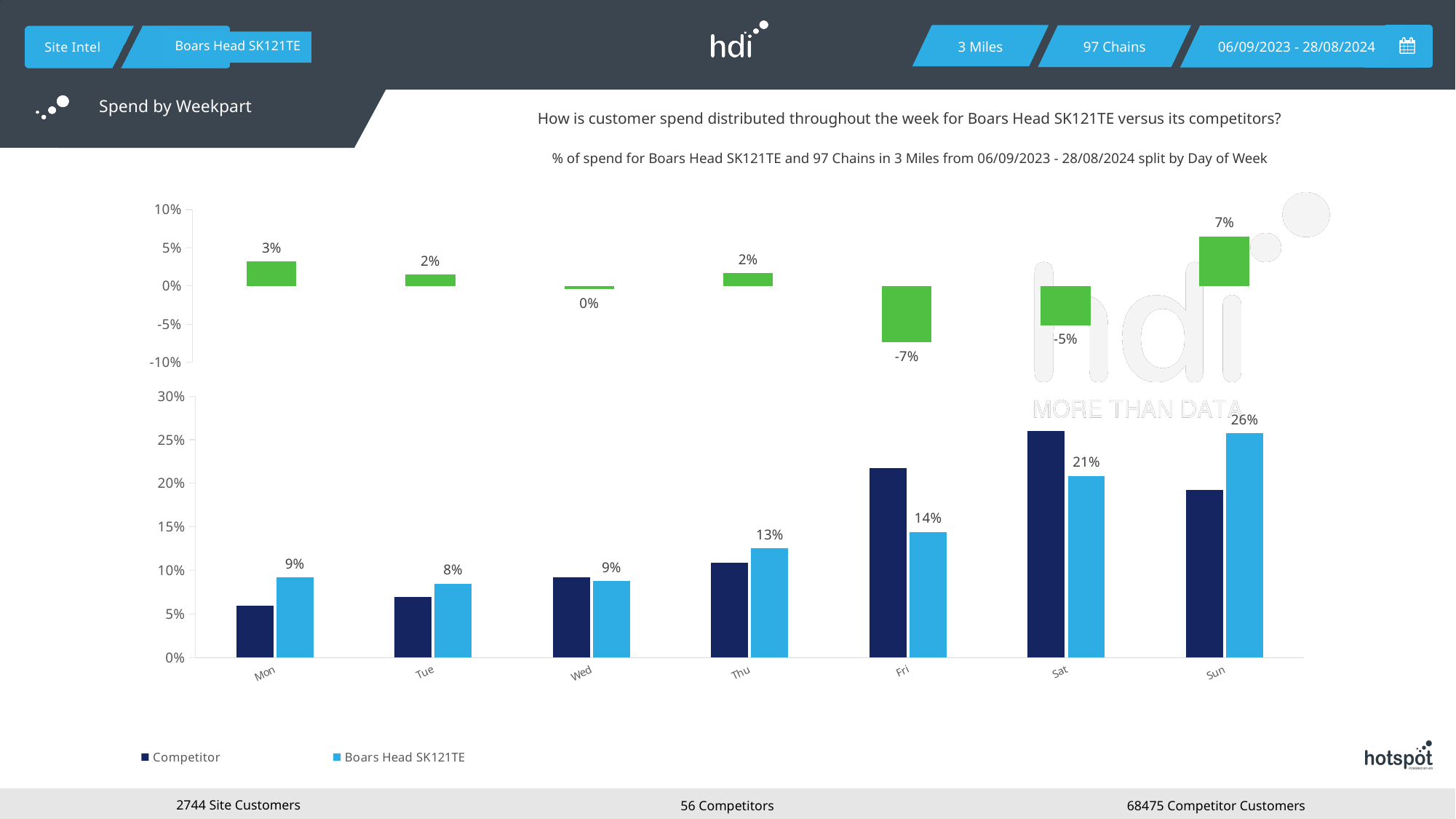
In the top chart, how many days are plotted? 7 What kind of chart is the bottom chart? bar chart In the bottom chart, what is the difference between the Boars Head SK121TE values for Sun and Sat? 5% In the bottom chart, on which day is the Boars Head SK121TE value highest? Sun In the bottom chart, is the Competitor value for Fri greater or less than 20%? greater In the bottom chart, which is larger on Sat: the Competitor bar or the Boars Head SK121TE bar? Competitor In the bottom chart, how many series does the legend list? 2 In the bottom chart, on which day is the Boars Head SK121TE value lowest? Tue In the bottom chart, what is the value for Boars Head SK121TE on Thu? 13% In the bottom chart, what is the value for Boars Head SK121TE on Sun? 26% In the top chart, what is the value for Fri? -7% In the top chart, which day has the highest value? Sun